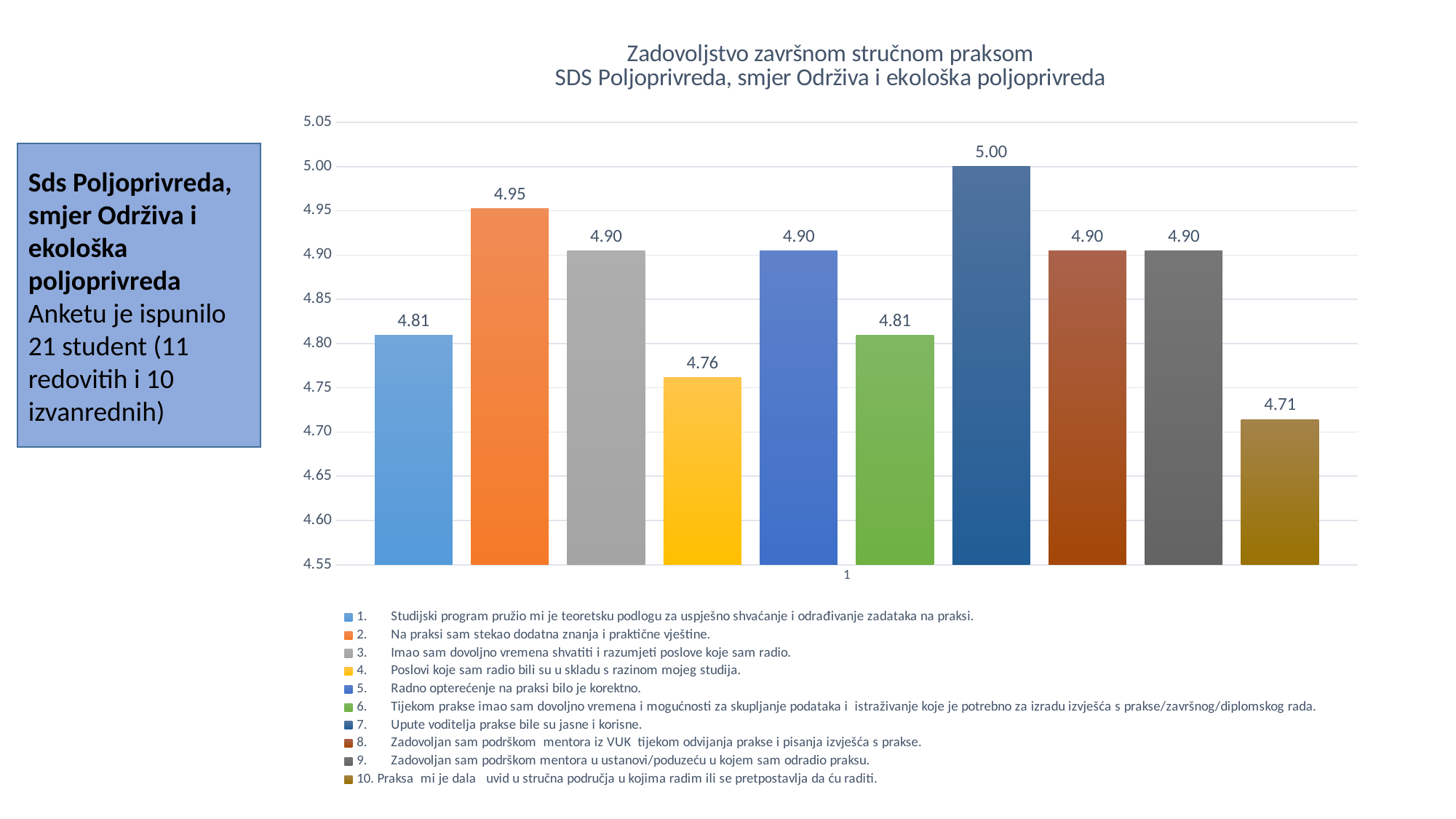
What is the title of the chart? Zadovoljstvo završnom stručnom praksom SDS Poljoprivreda, smjer Održiva i ekološka poljoprivreda Is the value for series 1, "Studijski program pružio mi je teoretsku podlogu...", greater or less than 4.85? less What is the value for series 2, "Na praksi sam stekao dodatna znanja i praktične vještine."? 4.95 How many series does the legend list? 10 What is the value for series 4, "Poslovi koje sam radio bili su u skladu s razinom mojeg studija."? 4.76 What is the value for series 10, "Praksa mi je dala uvid u stručna područja u kojima radim ili se pretpostavlja da ću raditi."? 4.71 What is the difference between the value for series 7 (5.00) and the value for series 10 (4.71)? 0.29 What is the value for series 7, "Upute voditelja prakse bile su jasne i korisne."? 5.00 Which series has the highest value? 7. Upute voditelja prakse bile su jasne i korisne. What type of chart is shown on the slide? bar chart Which is larger, the value for series 2 or the value for series 4? series 2 Which series has the lowest value? 10. Praksa mi je dala uvid u stručna područja u kojima radim ili se pretpostavlja da ću raditi.